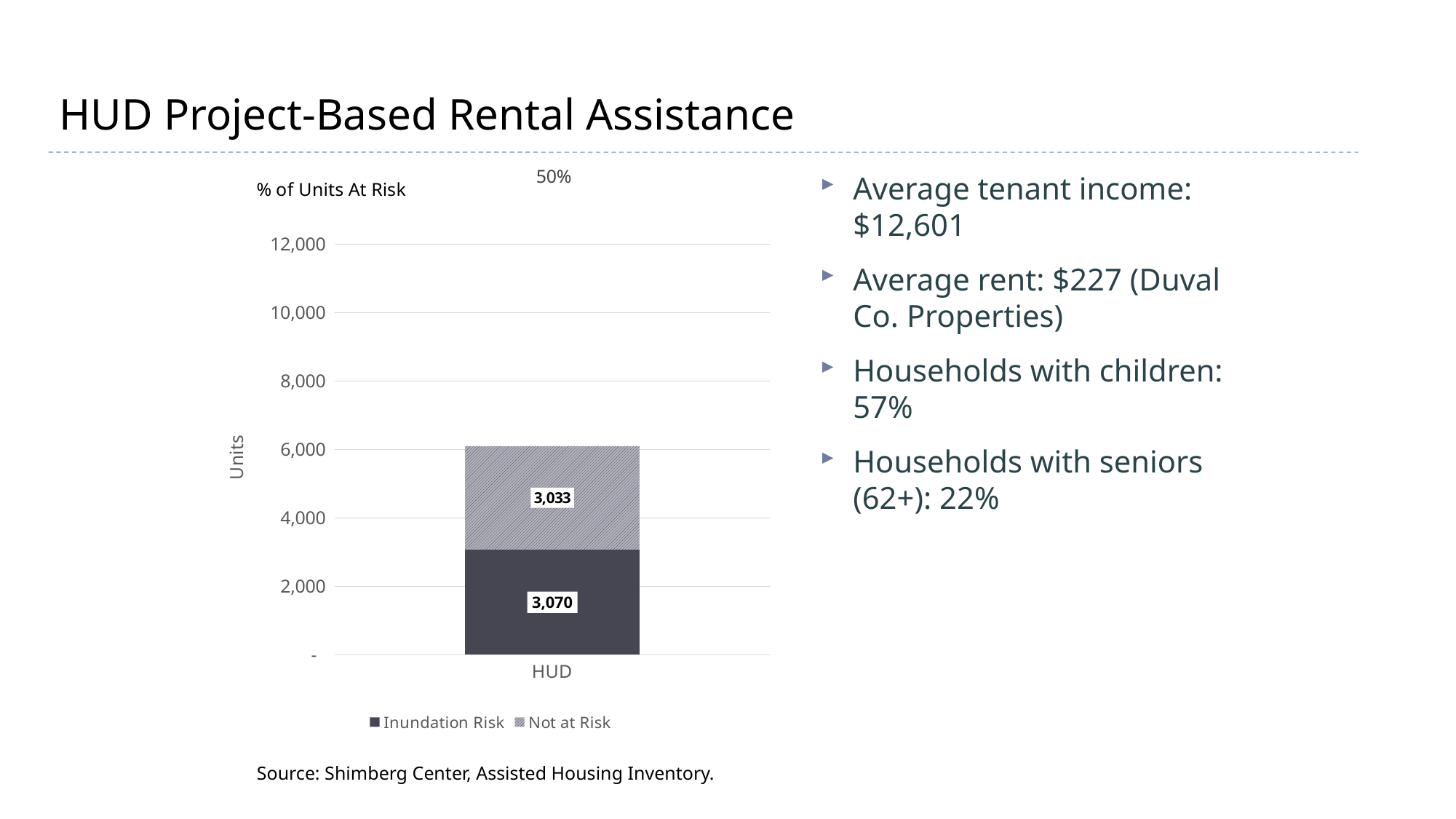
Is the total height of the HUD bar greater or less than 8,000? less What kind of chart is shown? Stacked bar chart How many categories are shown on the x axis? 1 How many series does the legend list? 2 What percentage of units is shown as at risk above the chart? 50% What is the difference between the Inundation Risk and Not at Risk values? 37 Which series has the larger value, Inundation Risk or Not at Risk? Inundation Risk What is the label on the vertical axis? Units What is the total of the stacked HUD bar? 6,103 What is the value for Inundation Risk in the HUD bar? 3,070 What is the value for Not at Risk in the HUD bar? 3,033